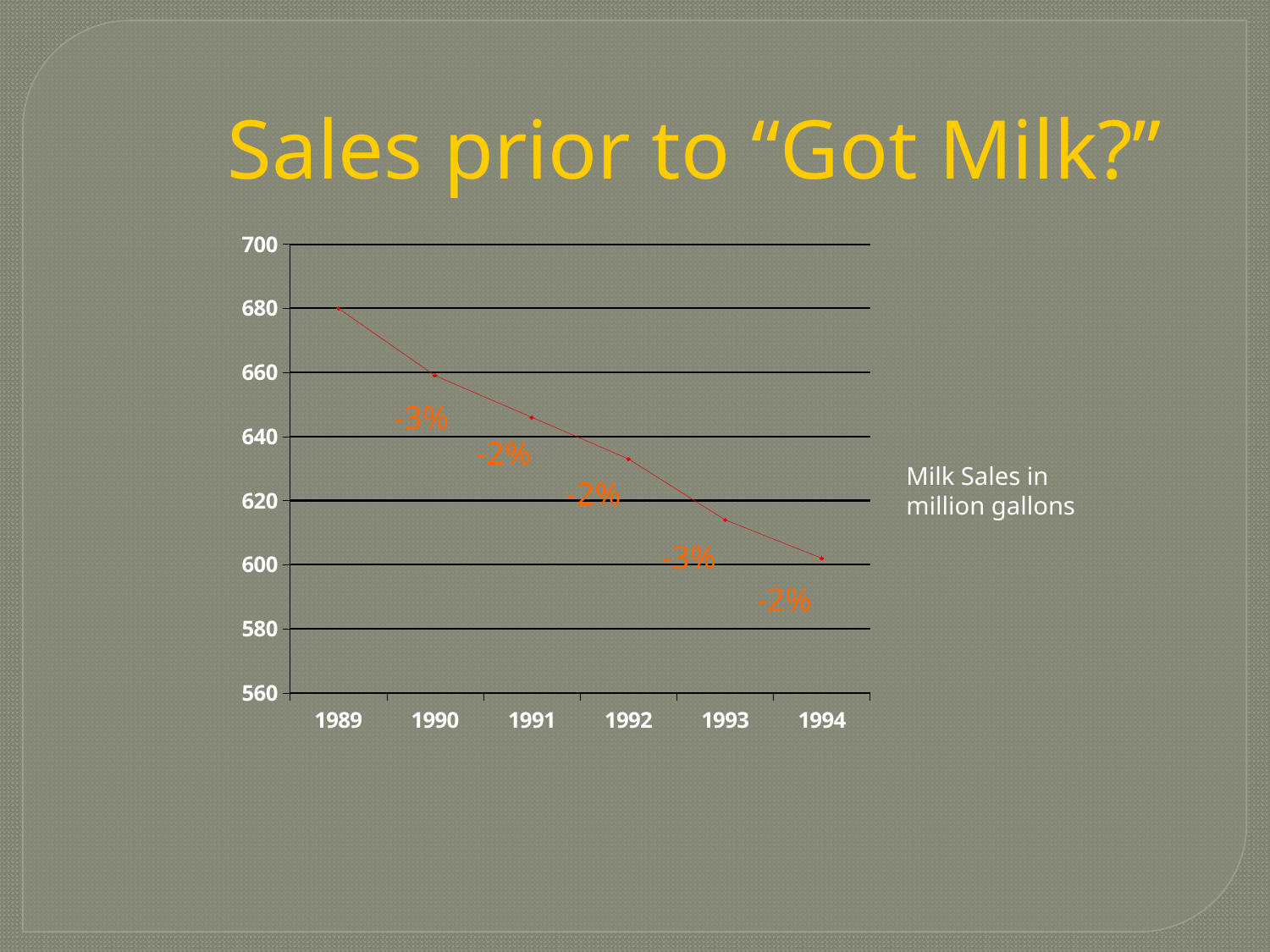
Is the value for 1994 greater or less than 620? less Is the value for 1990 greater or less than 640? greater What is the value of milk sales for 1989? 680 Which year has higher milk sales, 1991 or 1993? 1991 What kind of chart is shown on the slide? line chart Do milk sales rise or fall from 1989 to 1994? fall Which year has the lowest milk sales? 1994 How many years are plotted on the x axis of the chart? 6 Is the value for 1992 greater or less than 620? greater In what units are milk sales measured according to the text next to the chart? million gallons What is the title of the slide containing the chart? Sales prior to "Got Milk?" Which year has the highest milk sales? 1989